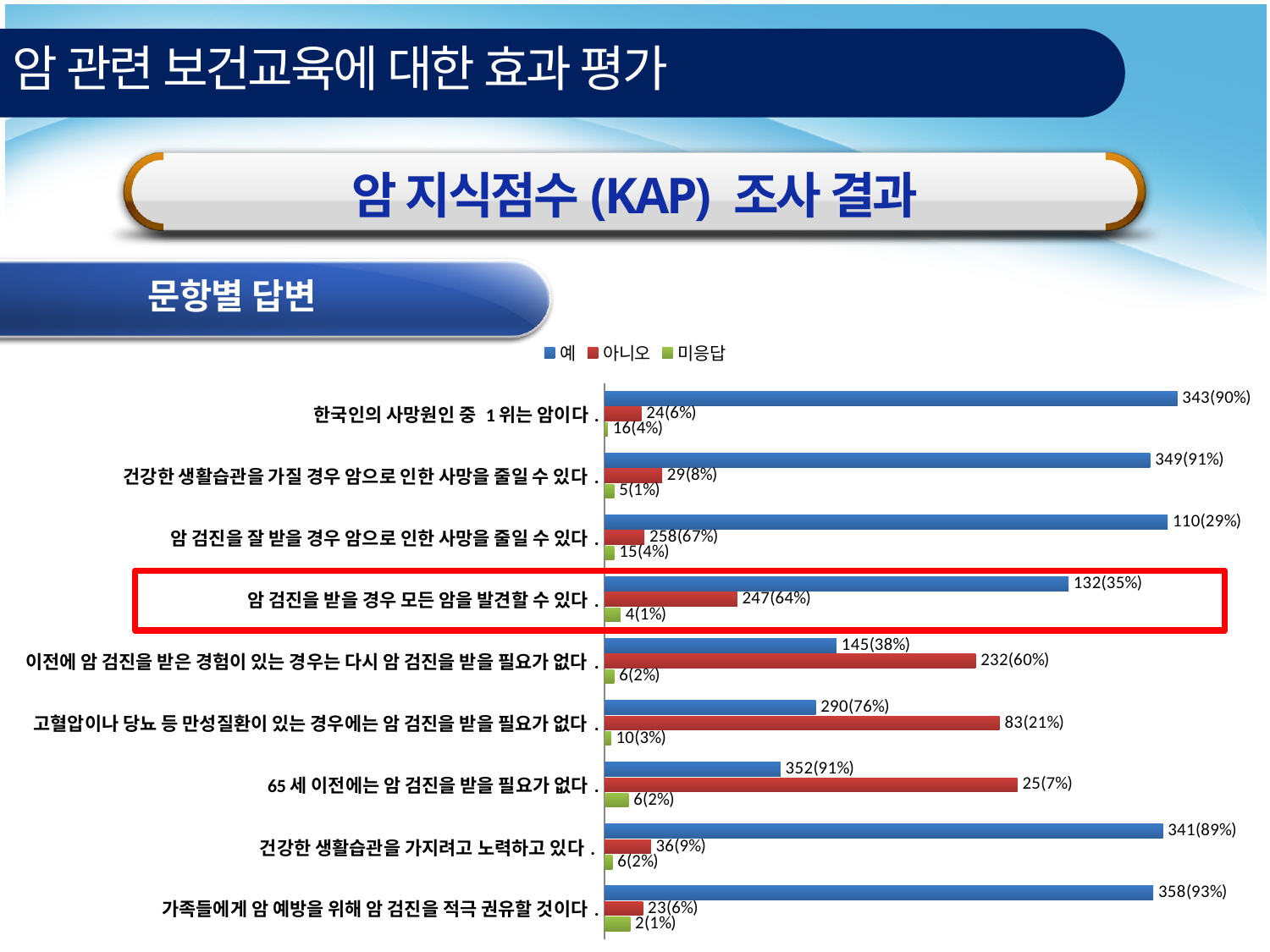
What is the 아니오 value for '암 검진을 받을 경우 모든 암을 발견할 수 있다'? 247(64%) What is the 예 value for '한국인의 사망원인 중 1위는 암이다'? 343(90%) What are the legend entries of the chart? 예, 아니오, 미응답 Which category is highlighted with a red box on the chart? 암 검진을 받을 경우 모든 암을 발견할 수 있다 What is the difference between the 예 count (343) and the 아니오 count (24) for '한국인의 사망원인 중 1위는 암이다'? 319 What is the 예 value for '가족들에게 암 예방을 위해 암 검진을 적극 권유할 것이다'? 358(93%) What is the 미응답 value for '고혈압이나 당뇨 등 만성질환이 있는 경우에는 암 검진을 받을 필요가 없다'? 10(3%) How many series does the legend list? 3 What is the 예 value for '65세 이전에는 암 검진을 받을 필요가 없다'? 352(91%) What is the 아니오 value for '이전에 암 검진을 받은 경험이 있는 경우는 다시 암 검진을 받을 필요가 없다'? 232(60%) How many question categories are plotted in the chart? 9 What type of chart is shown on the slide? bar chart